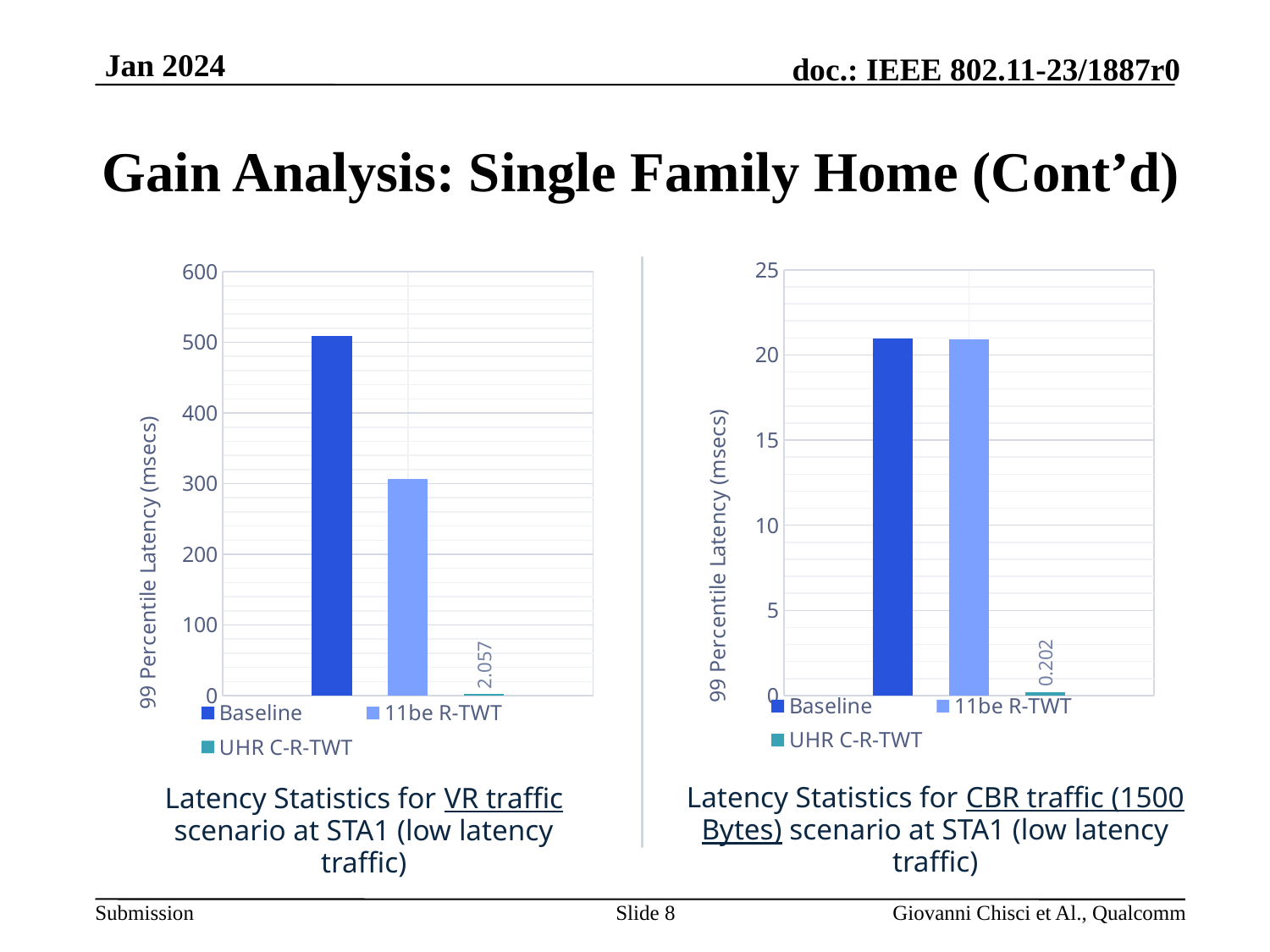
In the right chart (CBR traffic scenario), which series has the lowest 99 percentile latency? UHR C-R-TWT In the left chart (VR traffic scenario), is the value for Baseline greater or less than 500? greater In the left chart (VR traffic scenario), which series has the highest 99 percentile latency? Baseline What kind of chart is the left chart (VR traffic scenario)? Bar chart In the left chart (VR traffic scenario), is the value for 11be R-TWT greater or less than 400? less In the left chart (VR traffic scenario), what is the 99 percentile latency for UHR C-R-TWT? 2.057 What is the y-axis title of the right chart (CBR traffic scenario)? 99 Percentile Latency (msecs) In the left chart (VR traffic scenario), which is larger: the value for Baseline or the value for 11be R-TWT? Baseline In the left chart (VR traffic scenario), which series has the lowest 99 percentile latency? UHR C-R-TWT How many series does the legend of the right chart (CBR traffic scenario) list? 3 In the right chart (CBR traffic scenario), what is the 99 percentile latency for UHR C-R-TWT? 0.202 In the right chart (CBR traffic scenario), is the value for Baseline greater or less than 20? greater